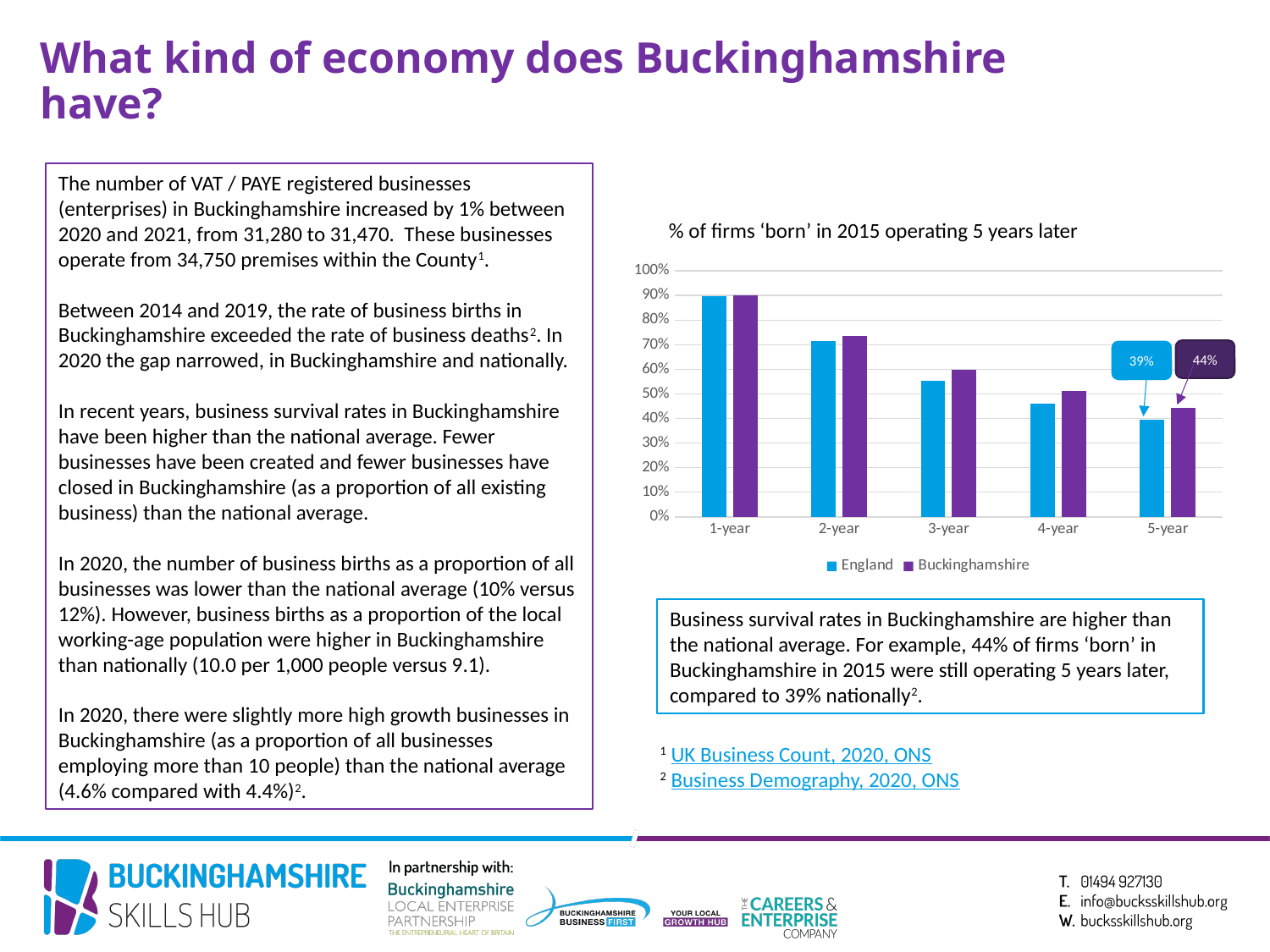
Is the value for England at 3-year greater or less than 50%? greater What is the value for Buckinghamshire at 5-year? 44% What kind of chart is shown on the slide? Bar chart Which category has the highest value for England? 1-year At 5-year, which series has the larger value, England or Buckinghamshire? Buckinghamshire How many series does the legend list? 2 What is the difference between the Buckinghamshire and England values at 5-year? 5% Do the values for Buckinghamshire rise or fall from 1-year to 5-year? Fall Which category has the lowest value for Buckinghamshire? 5-year Is the value for Buckinghamshire at 4-year greater or less than 60%? less How many categories are shown on the x axis? 5 What is the value for England at 5-year? 39%